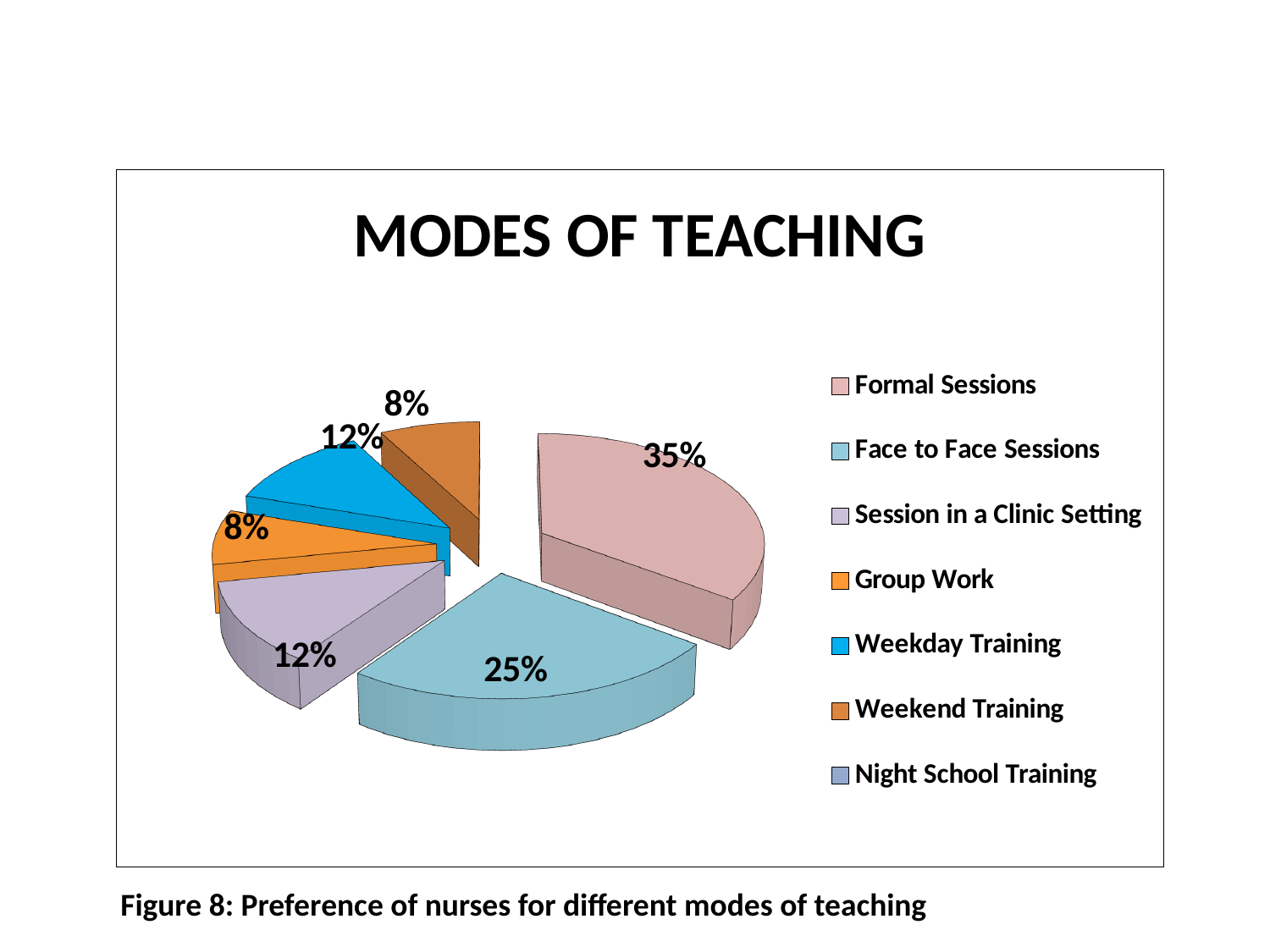
Which mode of teaching has the largest share of the pie? Formal Sessions What type of chart is shown on the slide? pie chart What percentage of nurses preferred Formal Sessions? 35% What percentage is shown for Weekend Training? 8% How many entries does the legend list? 7 What share of the pie is Session in a Clinic Setting? 12% What percentage is shown for Group Work? 8% What is the difference in percentage points between Formal Sessions and Face to Face Sessions? 10 What is the title of the chart? MODES OF TEACHING Which is larger, the share for Weekday Training or the share for Weekend Training? Weekday Training What percentage of nurses preferred Face to Face Sessions? 25% What percentage is shown for Weekday Training? 12%